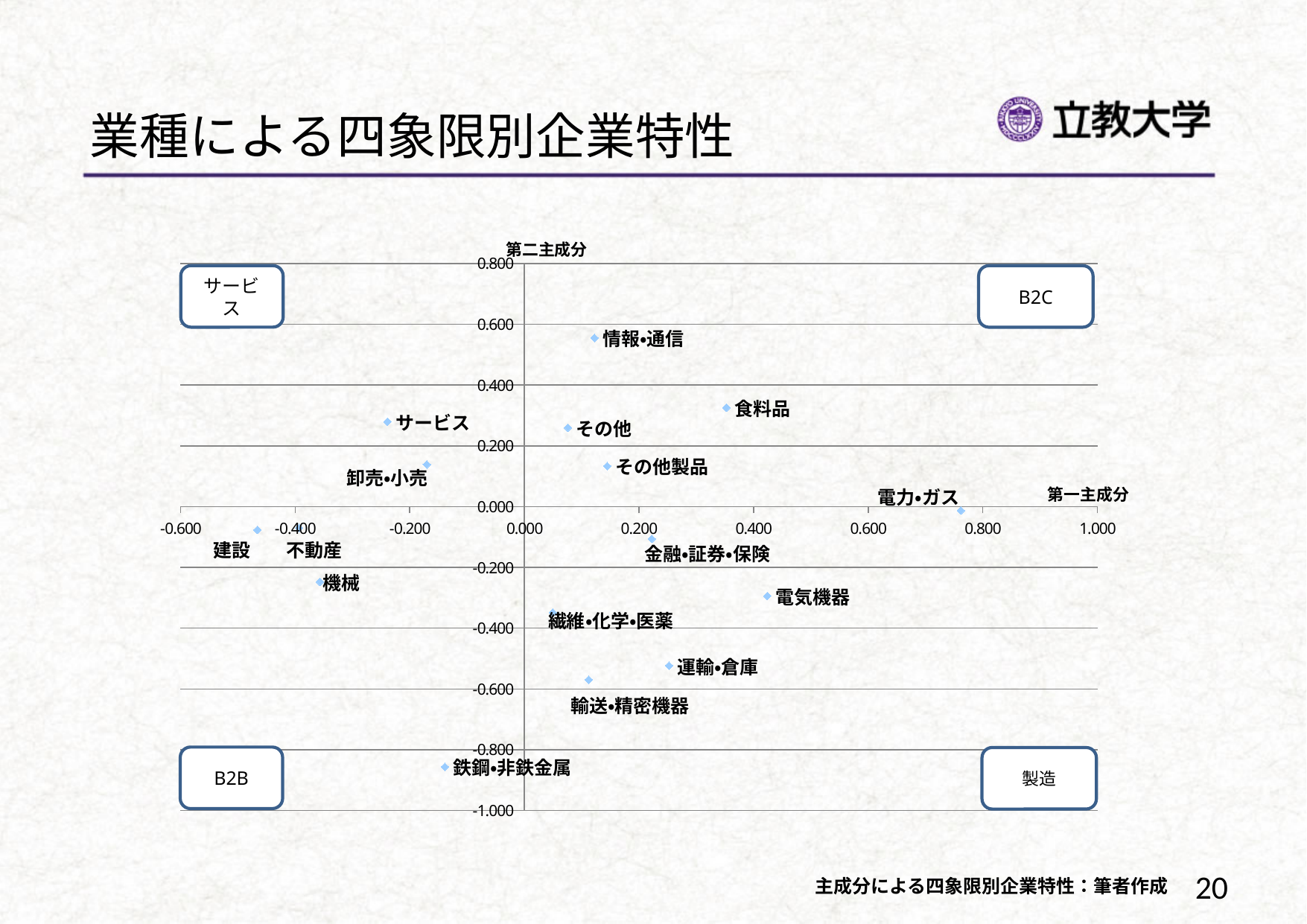
Which has the higher 第二主成分 value, 情報・通信 or 食料品? 情報・通信 Which industry has the highest value on the 第二主成分 (vertical) axis? 情報・通信 Which industry has the lowest value on the 第二主成分 (vertical) axis? 鉄鋼・非鉄金属 What label is shown in the box in the top-right quadrant of the chart? B2C Is the 第一主成分 value for 電力・ガス greater or less than 0.600? greater Is the 第二主成分 value for 鉄鋼・非鉄金属 greater or less than -0.800? less Which industry has the lowest value on the 第一主成分 (horizontal) axis? 建設 How many industry points are plotted on the chart? 16 Is the 第二主成分 value for 運輸・倉庫 greater or less than -0.400? less What kind of chart is shown on the slide? scatter chart Which industry has the highest value on the 第一主成分 (horizontal) axis? 電力・ガス